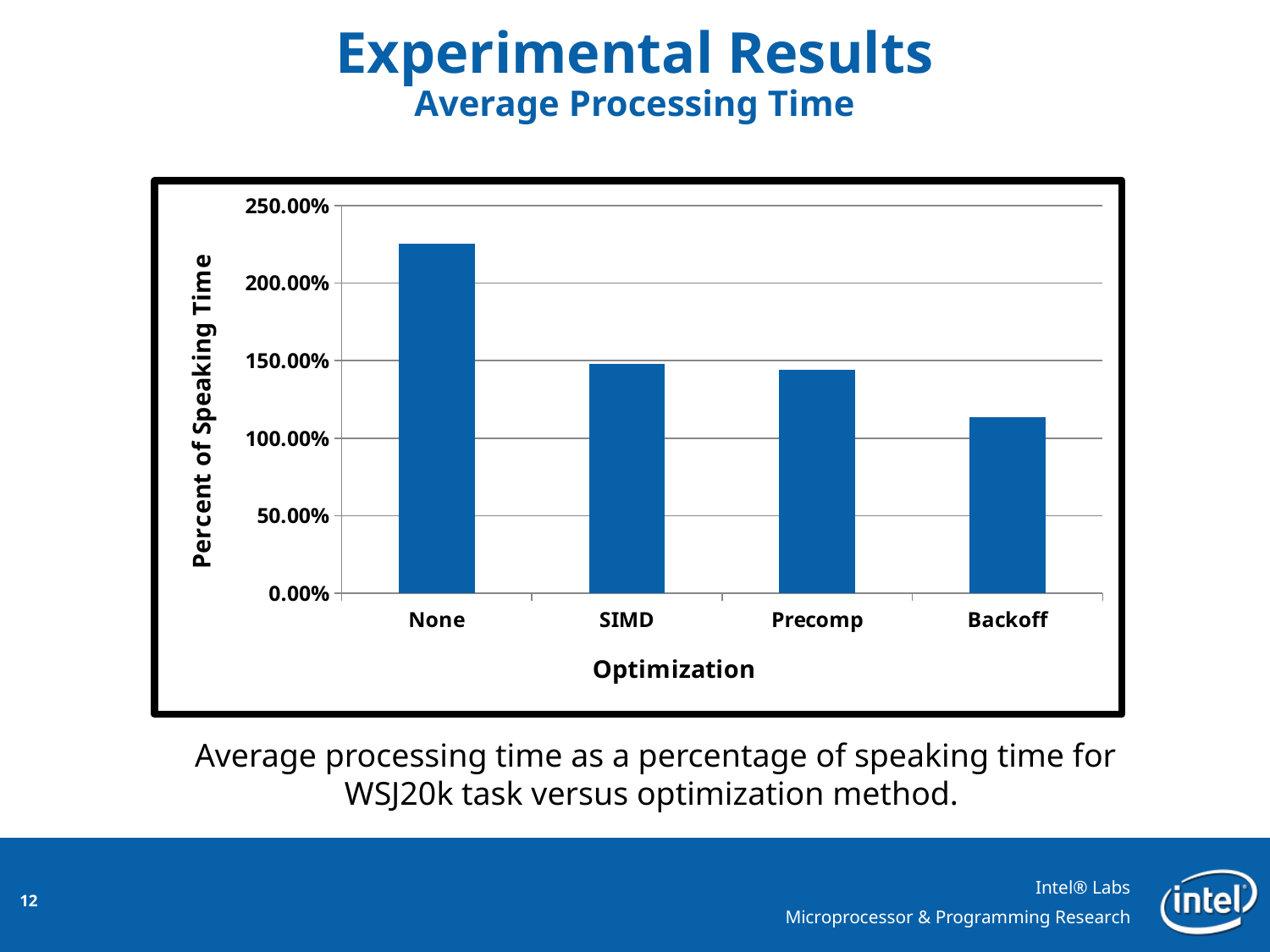
Which has a larger value, Precomp or Backoff? Precomp What is the label of the y axis? Percent of Speaking Time Is the value for Backoff greater or less than 150.00%? less Is the value for None greater or less than 200.00%? greater Which optimization has the lowest percent of speaking time? Backoff What kind of chart is shown on the slide? Bar chart Is the value for SIMD greater or less than 100.00%? greater Which has a larger value, None or Backoff? None Which has a larger value, None or SIMD? None How many optimization categories are plotted on the x axis? 4 Which optimization has the highest percent of speaking time? None Do the values rise or fall moving from None to Backoff along the x axis? Fall